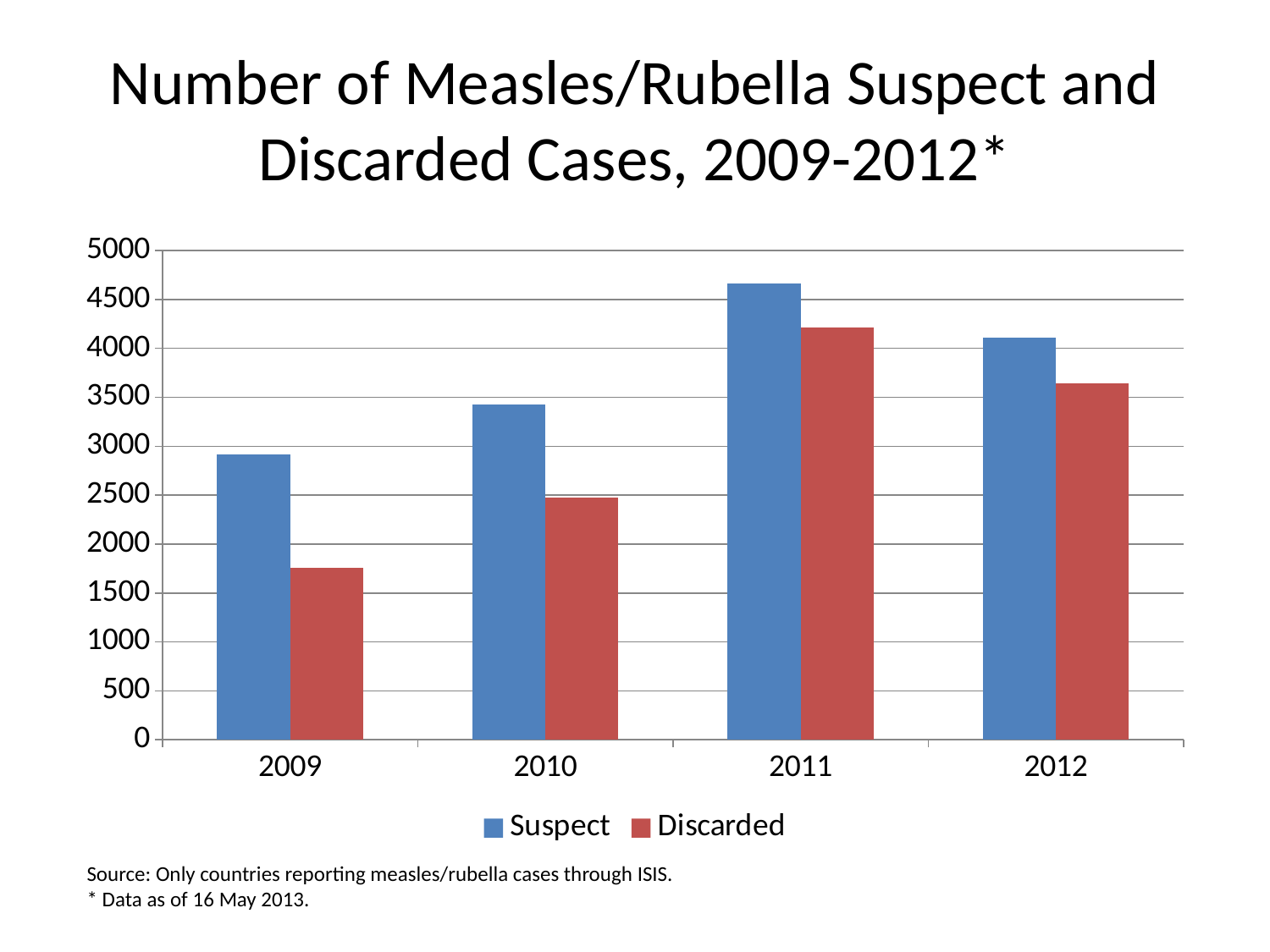
Is the value for Suspect cases in 2009 greater or less than 2500? greater Which is larger, the number of Suspect cases in 2011 or in 2012? 2011 Is the value for Discarded cases in 2009 greater or less than 2000? less How many years are shown on the x axis? 4 Is the value for Suspect cases in 2011 greater or less than 4500? greater In which year is the number of Discarded cases lowest? 2009 Which colour represents the Discarded series in the chart? Red How many series does the legend list? 2 In which year is the number of Suspect cases highest? 2011 What kind of chart is shown on the slide? Bar chart Which is larger in 2010, Suspect cases or Discarded cases? Suspect